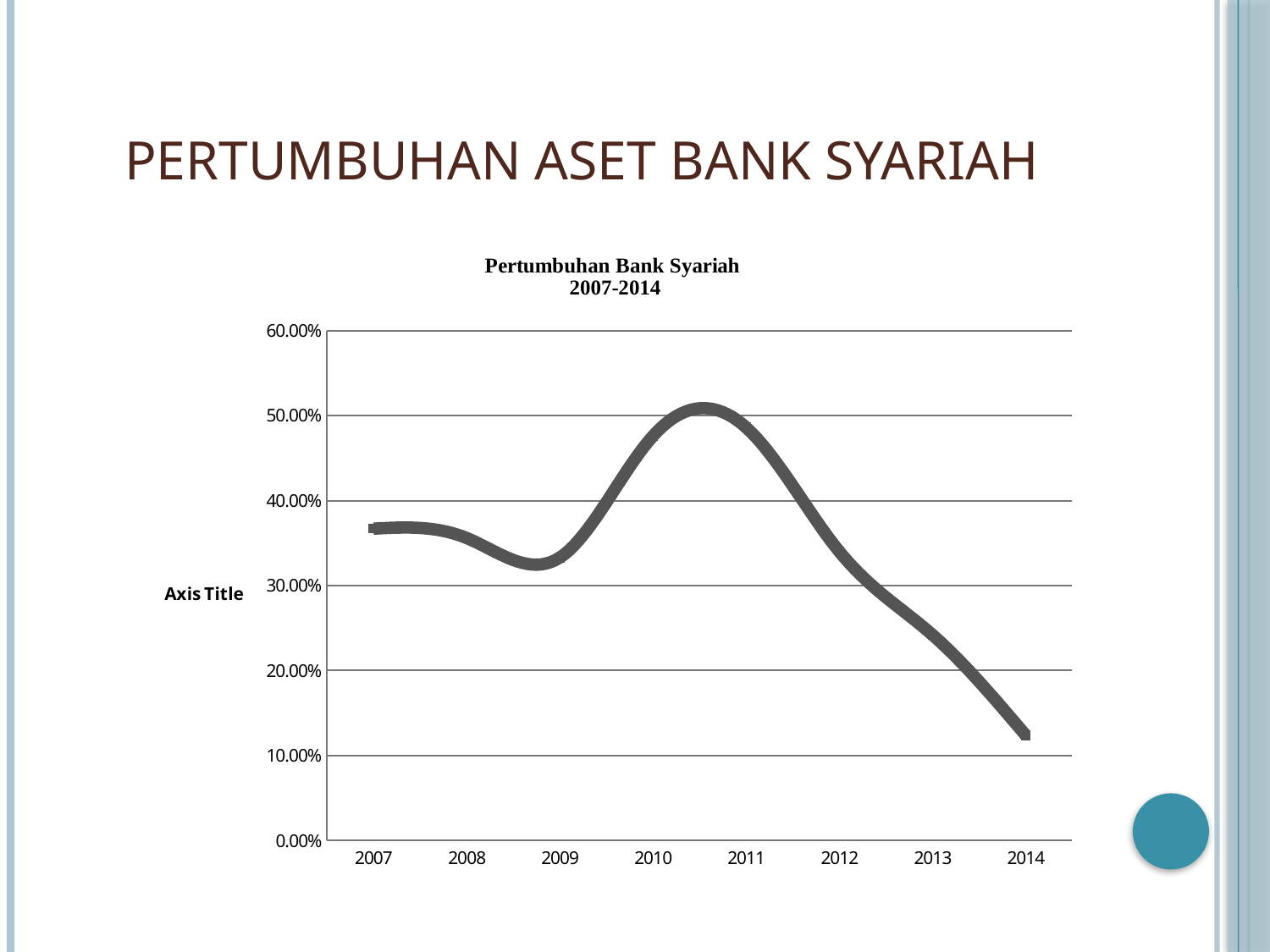
How many years are plotted on the x axis of the chart? 8 Which is larger, the value for 2010 or the value for 2009? 2010 Which year has the lowest value on the chart? 2014 What is the title of the chart? Pertumbuhan Bank Syariah 2007-2014 Is the value for 2014 greater or less than 20.00%? less Is the value for 2007 greater or less than 40.00%? less Which is larger, the value for 2007 or the value for 2014? 2007 Is the value for 2007 greater or less than 30.00%? greater Do the values rise or fall from 2011 to 2014? fall What kind of chart is shown on the slide? line chart